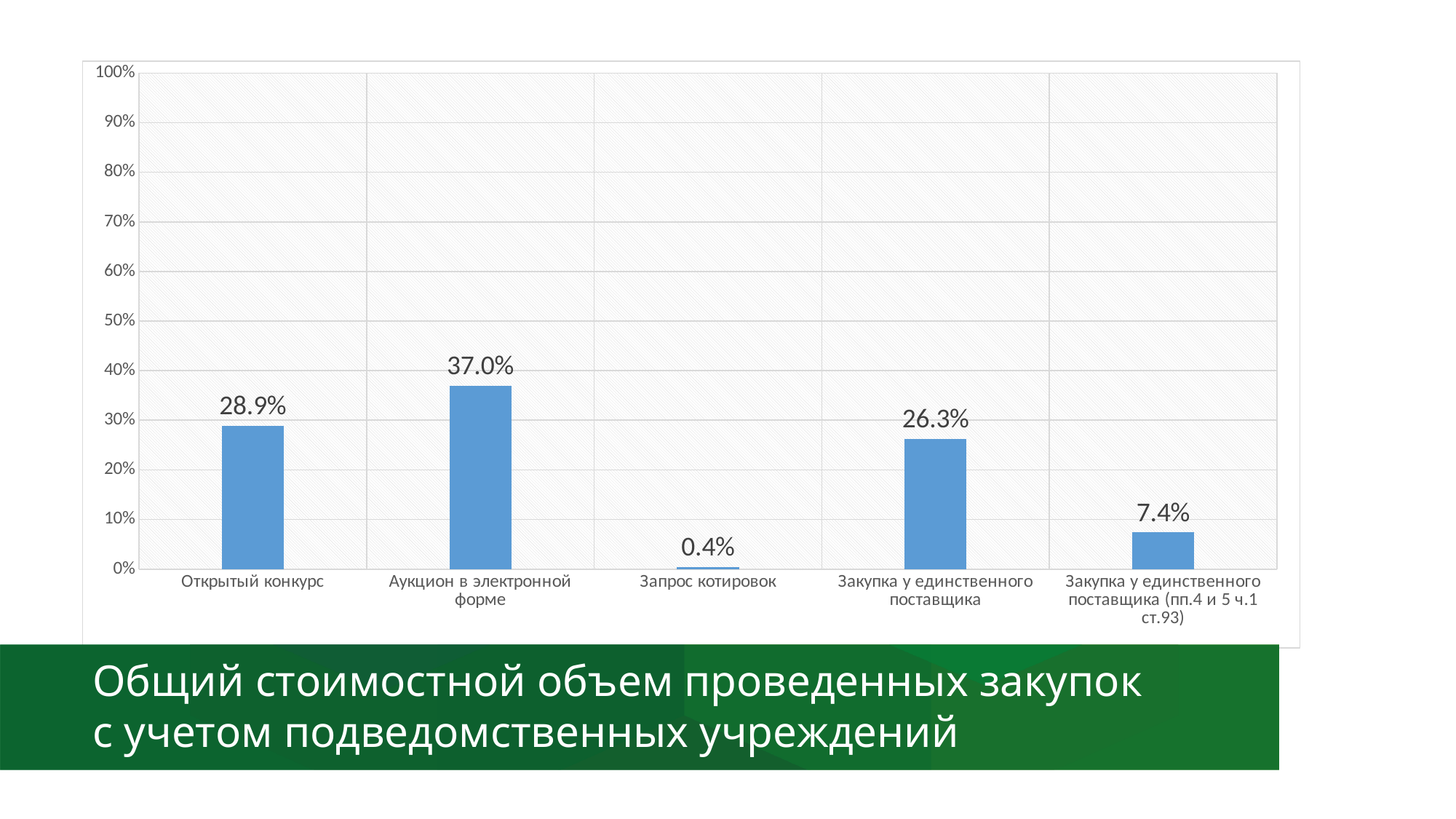
Which category has the highest value? Аукцион в электронной форме What is the difference between the values for Аукцион в электронной форме and Открытый конкурс? 8.1% Is the value for Закупка у единственного поставщика greater or less than 30%? less What is the value for Запрос котировок? 0.4% What is the value for Открытый конкурс? 28.9% Which is larger: the value for Открытый конкурс or the value for Закупка у единственного поставщика? Открытый конкурс What is the value for Аукцион в электронной форме? 37.0% What kind of chart is shown on the slide? bar chart What is the value for Закупка у единственного поставщика (пп.4 и 5 ч.1 ст.93)? 7.4% Which category has the lowest value? Запрос котировок What is the title shown in the green banner below the chart? Общий стоимостной объем проведенных закупок с учетом подведомственных учреждений How many categories are shown on the x axis? 5